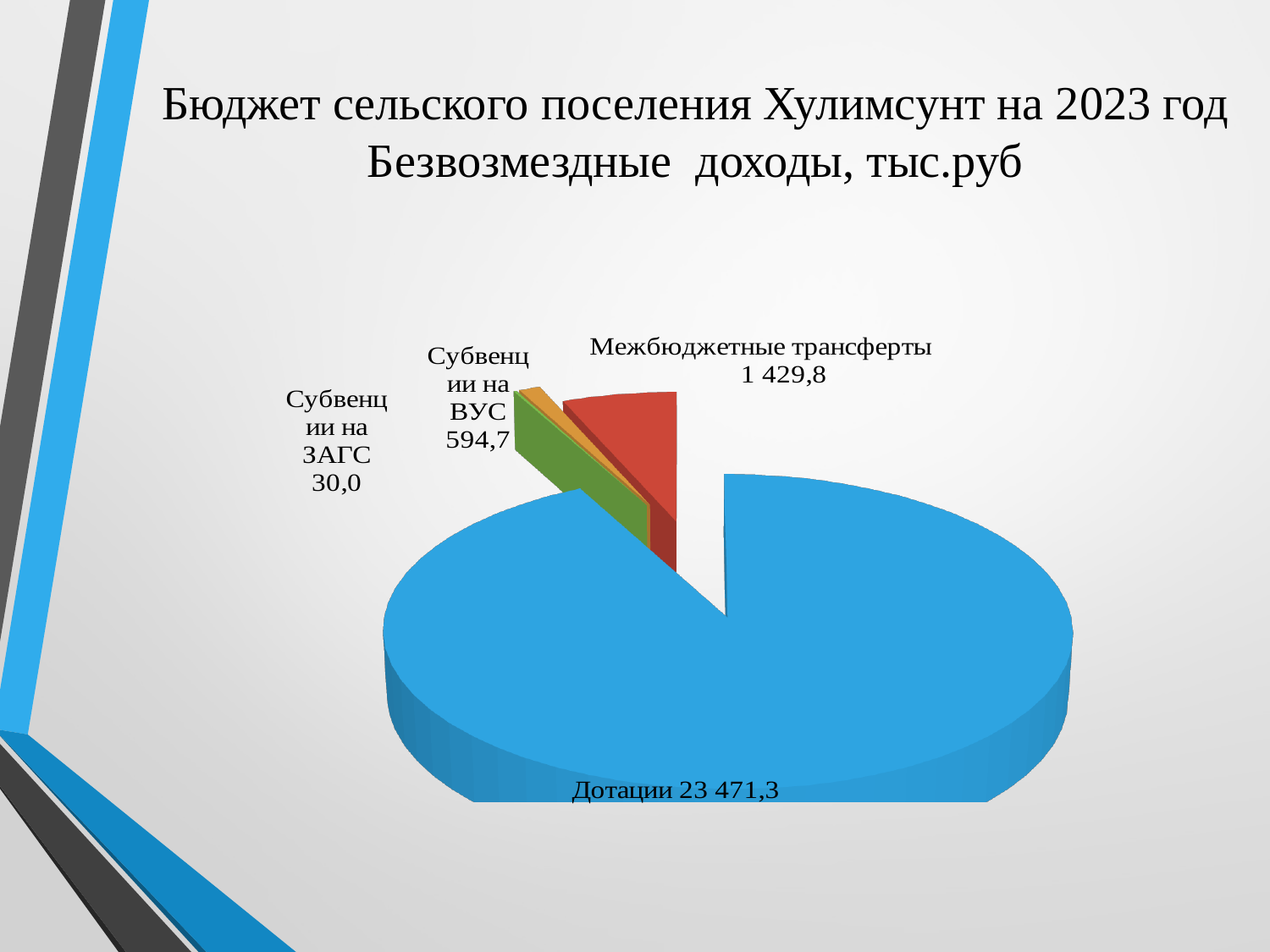
What is the difference between Субвенции на ВУС and Субвенции на ЗАГС? 564,7 Which category has the largest value? Дотации How many slices does the pie chart have? 4 What is the value for Межбюджетные трансферты? 1 429,8 Which category has the smallest value? Субвенции на ЗАГС Which is larger, Межбюджетные трансферты or Субвенции на ВУС? Межбюджетные трансферты What is the title of the chart on the slide? Бюджет сельского поселения Хулимсунт на 2023 год Безвозмездные доходы, тыс.руб What type of chart is shown on the slide? Pie chart What is the value for Дотации? 23 471,3 What is the value for Субвенции на ЗАГС? 30,0 What is the difference between Межбюджетные трансферты and Субвенции на ВУС? 835,1 What is the value for Субвенции на ВУС? 594,7